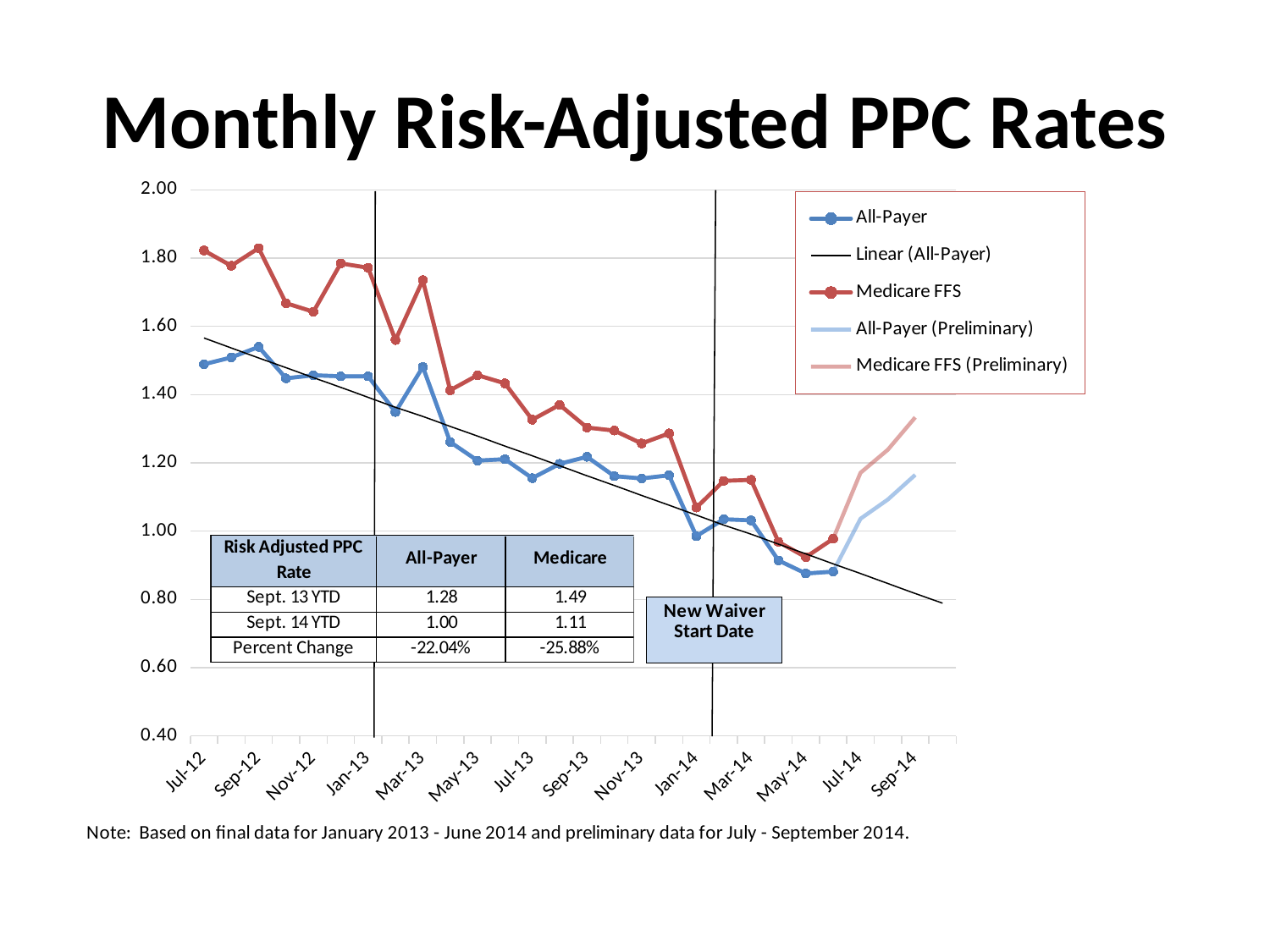
Which series is drawn in red? Medicare FFS Is the Medicare FFS value for Sep-13 greater or less than 1.40? less At Jul-12, which series has the higher value, All-Payer or Medicare FFS? Medicare FFS What kind of chart is shown on the slide? Line chart How many series does the legend list? 5 Is the All-Payer value for Jul-12 greater or less than 1.40? greater Does the All-Payer series generally rise or fall from Jul-12 to Jun-14? Fall What is the title of the chart? Monthly Risk-Adjusted PPC Rates How many month labels are shown on the x axis? 14 In which month does the All-Payer series reach its highest value? Sep-12 Is the All-Payer value for May-14 greater or less than 1.00? less